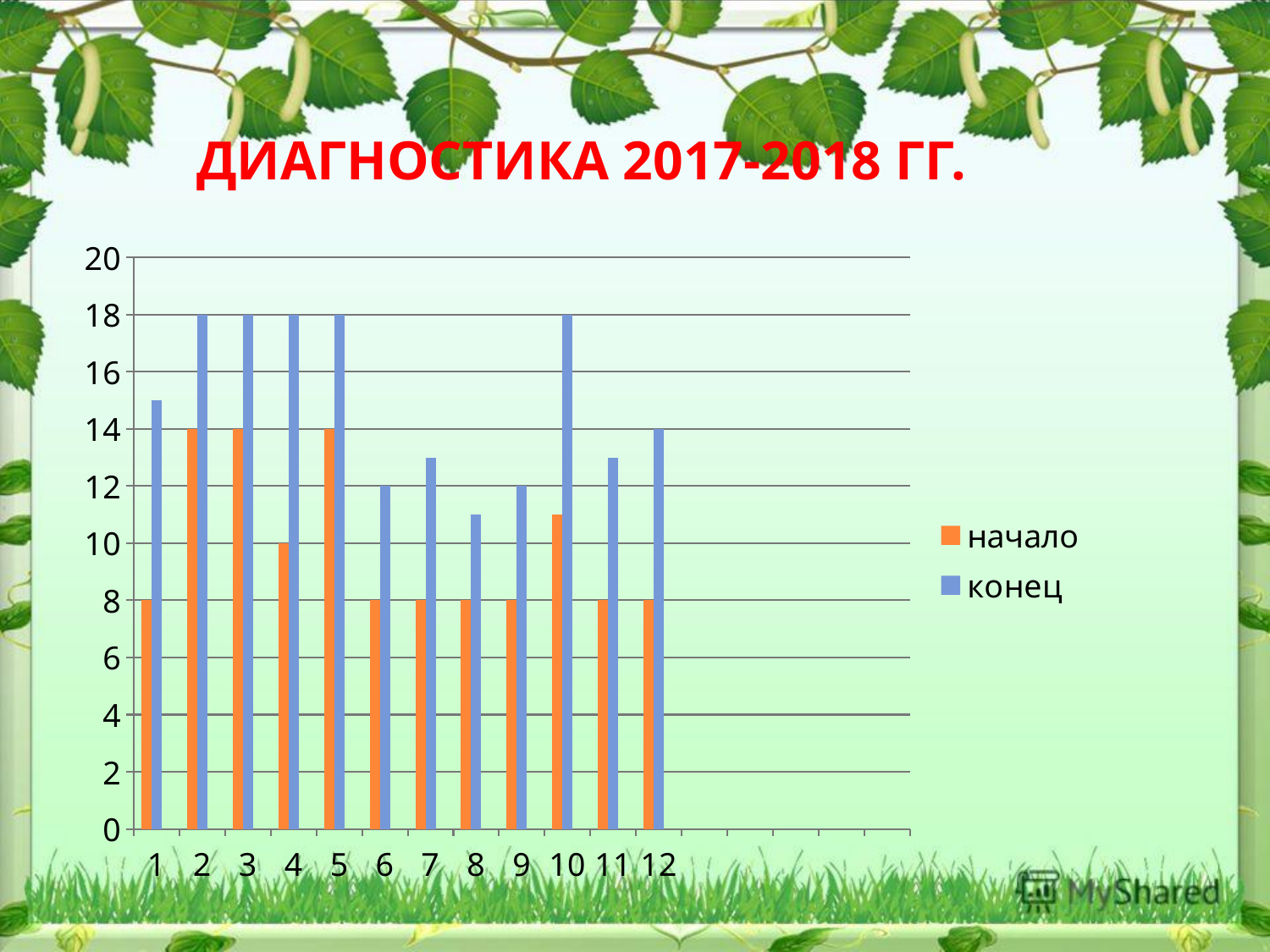
What is the difference between конец and начало for category 4? 8 How many series does the legend list? 2 What kind of chart is shown on the slide? bar chart Is the value of конец for category 1 greater or less than 16? less What is the value of конец for category 2? 18 What is the value of конец for category 12? 14 What is the value of начало for category 2? 14 What is the value of начало for category 4? 10 What is the title of the chart? ДИАГНОСТИКА 2017-2018 ГГ. How many categories are shown on the x axis? 12 Is the value of конец for category 7 greater or less than 12? greater For category 1, which is larger: начало or конец? конец